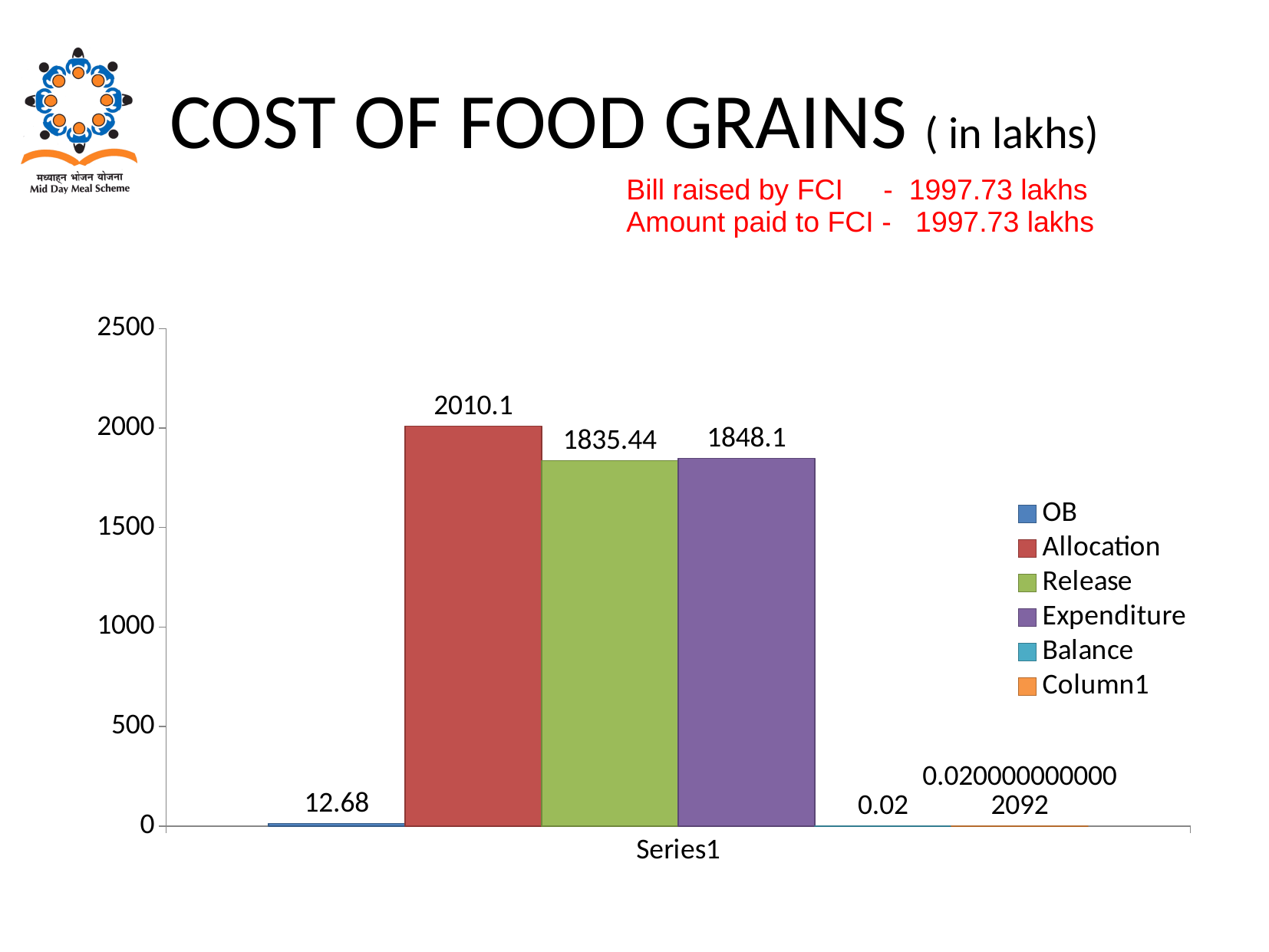
What is the value of the OB bar? 12.68 What is the value of the Balance bar? 0.02 What is the difference between the Allocation value and the Expenditure value? 162 What is the value of the Release bar? 1835.44 Is the value for Allocation greater or less than 2000? greater What is the value of the Allocation bar? 2010.1 Which is larger, the Release value or the Expenditure value? Expenditure Which legend entry has the highest value? Allocation What kind of chart is shown on the slide? Bar chart How many entries does the legend list? 6 What is the value of the Expenditure bar? 1848.1 What is the difference between the Expenditure value and the Release value? 12.66